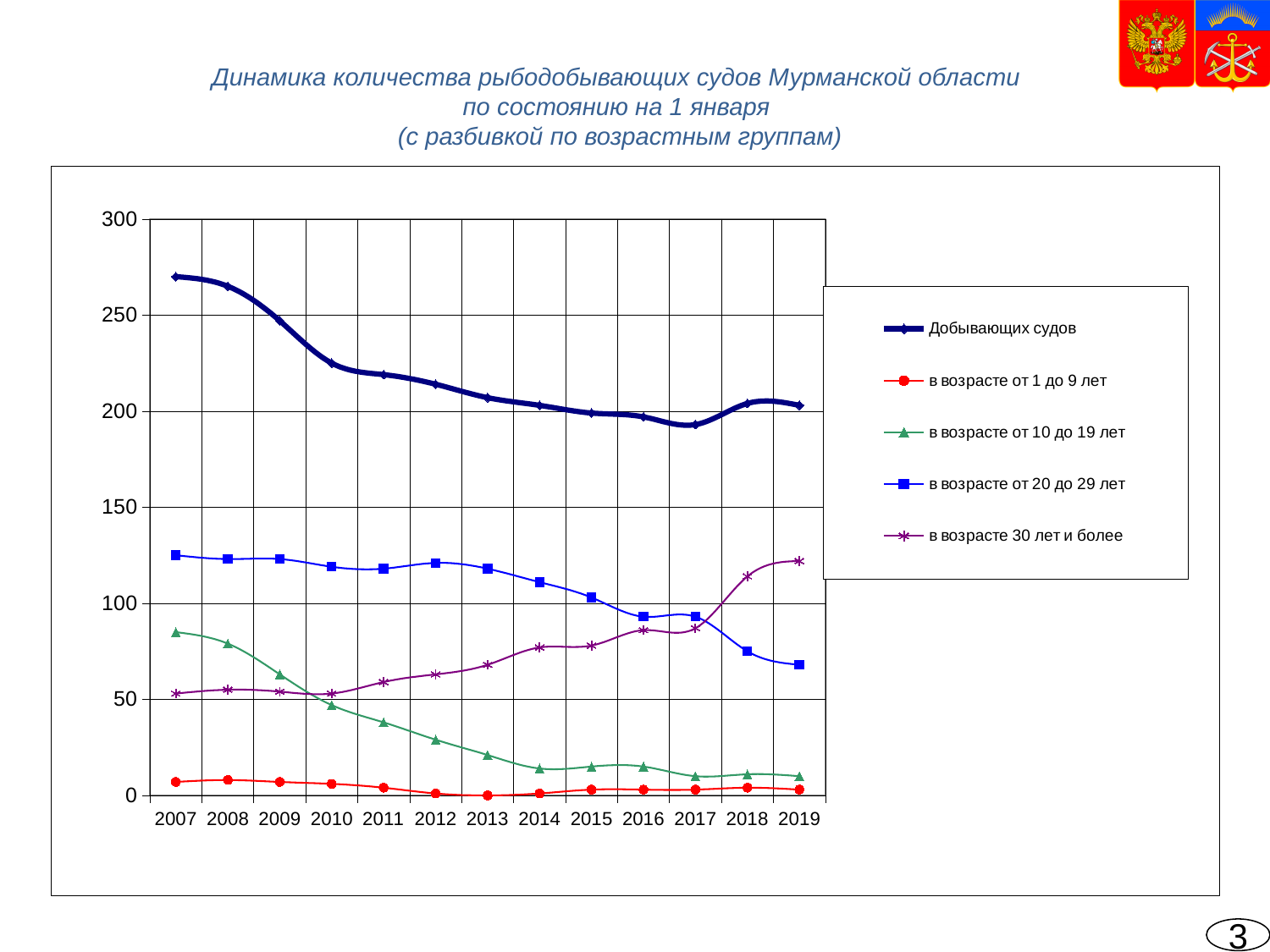
Is the value for "Добывающих судов" in 2017 greater or less than 200? less How many years are shown on the x axis? 13 What kind of chart is shown on the slide? line chart Does the series "в возрасте 30 лет и более" rise or fall overall from 2007 to 2019? rise How many series does the legend list? 5 In which year is the value for "Добывающих судов" highest? 2007 Does the series "в возрасте от 10 до 19 лет" rise or fall overall from 2007 to 2019? fall Does the series "Добывающих судов" rise or fall overall from 2007 to 2019? fall In 2019, which is larger: "в возрасте 30 лет и более" or "в возрасте от 20 до 29 лет"? в возрасте 30 лет и более Is the value for "в возрасте от 20 до 29 лет" in 2019 greater or less than 100? less Is the value for "в возрасте 30 лет и более" in 2019 greater or less than 100? greater